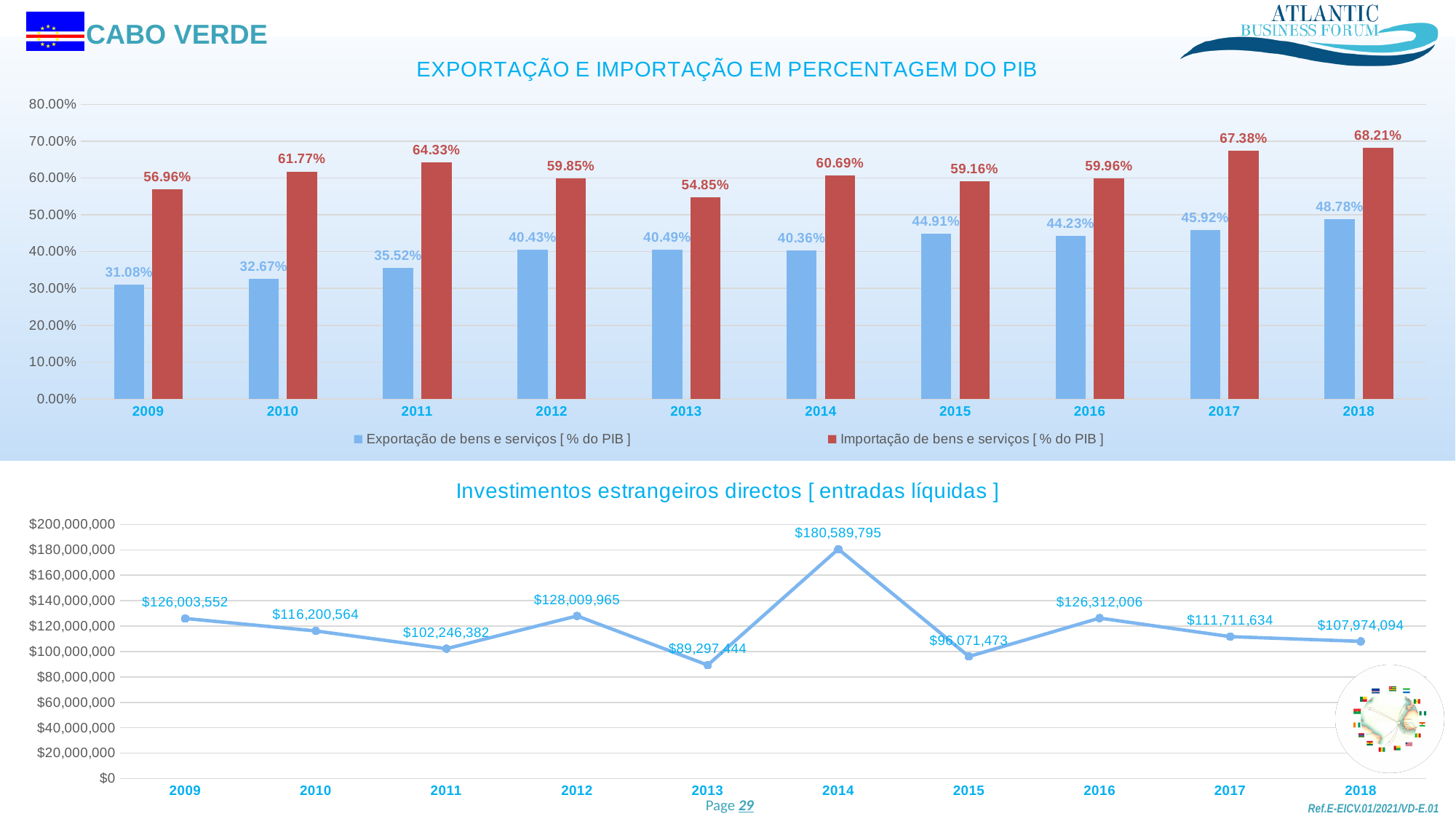
In the chart 'EXPORTAÇÃO E IMPORTAÇÃO EM PERCENTAGEM DO PIB', how many series does the legend list? 2 In the chart 'EXPORTAÇÃO E IMPORTAÇÃO EM PERCENTAGEM DO PIB', which year has the lowest Exportação de bens e serviços value? 2009 In the chart 'Investimentos estrangeiros directos [ entradas líquidas ]', what is the difference between the 2014 and 2013 values? $91,292,351 In the chart 'EXPORTAÇÃO E IMPORTAÇÃO EM PERCENTAGEM DO PIB', which year has the highest Importação de bens e serviços value? 2018 In the chart 'Investimentos estrangeiros directos [ entradas líquidas ]', what is the value for 2016? $126,312,006 In the chart 'EXPORTAÇÃO E IMPORTAÇÃO EM PERCENTAGEM DO PIB', what is the difference between Importação and Exportação in 2018? 19.43% In the chart 'Investimentos estrangeiros directos [ entradas líquidas ]', which year has the highest value? 2014 What kind of chart is 'EXPORTAÇÃO E IMPORTAÇÃO EM PERCENTAGEM DO PIB'? Bar chart In the chart 'EXPORTAÇÃO E IMPORTAÇÃO EM PERCENTAGEM DO PIB', what is the value of Importação de bens e serviços for 2011? 64.33% In the chart 'Investimentos estrangeiros directos [ entradas líquidas ]', how many years are plotted? 10 In the chart 'EXPORTAÇÃO E IMPORTAÇÃO EM PERCENTAGEM DO PIB', what is the value of Exportação de bens e serviços for 2013? 40.49% In the chart 'Investimentos estrangeiros directos [ entradas líquidas ]', which year has the lowest value? 2013